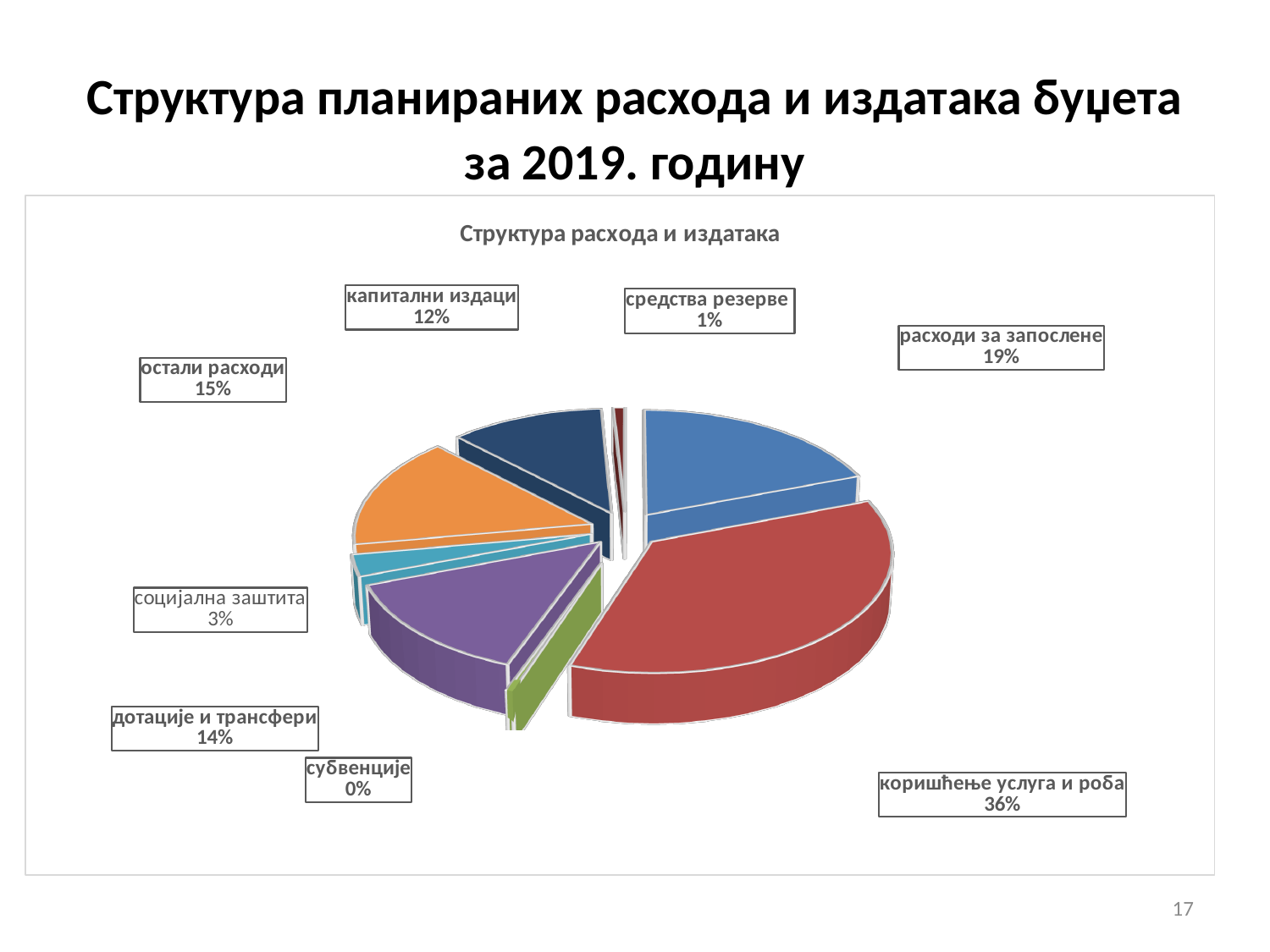
What is the chart's title? Структура расхода и издатака What share of the pie is расходи за запослене? 19% Which category has the largest share of the pie? коришћење услуга и роба How many categories are shown in the pie chart? 8 Which category has the smallest share of the pie? субвенције Which is larger, остали расходи or дотације и трансфери? остали расходи What percentage is shown for капитални издаци? 12% What is the difference in percentage points between коришћење услуга и роба and расходи за запослене? 17 What share of the pie is коришћење услуга и роба? 36% What percentage is shown for дотације и трансфери? 14% What kind of chart is shown on the slide? pie chart What percentage is shown for средства резерве? 1%